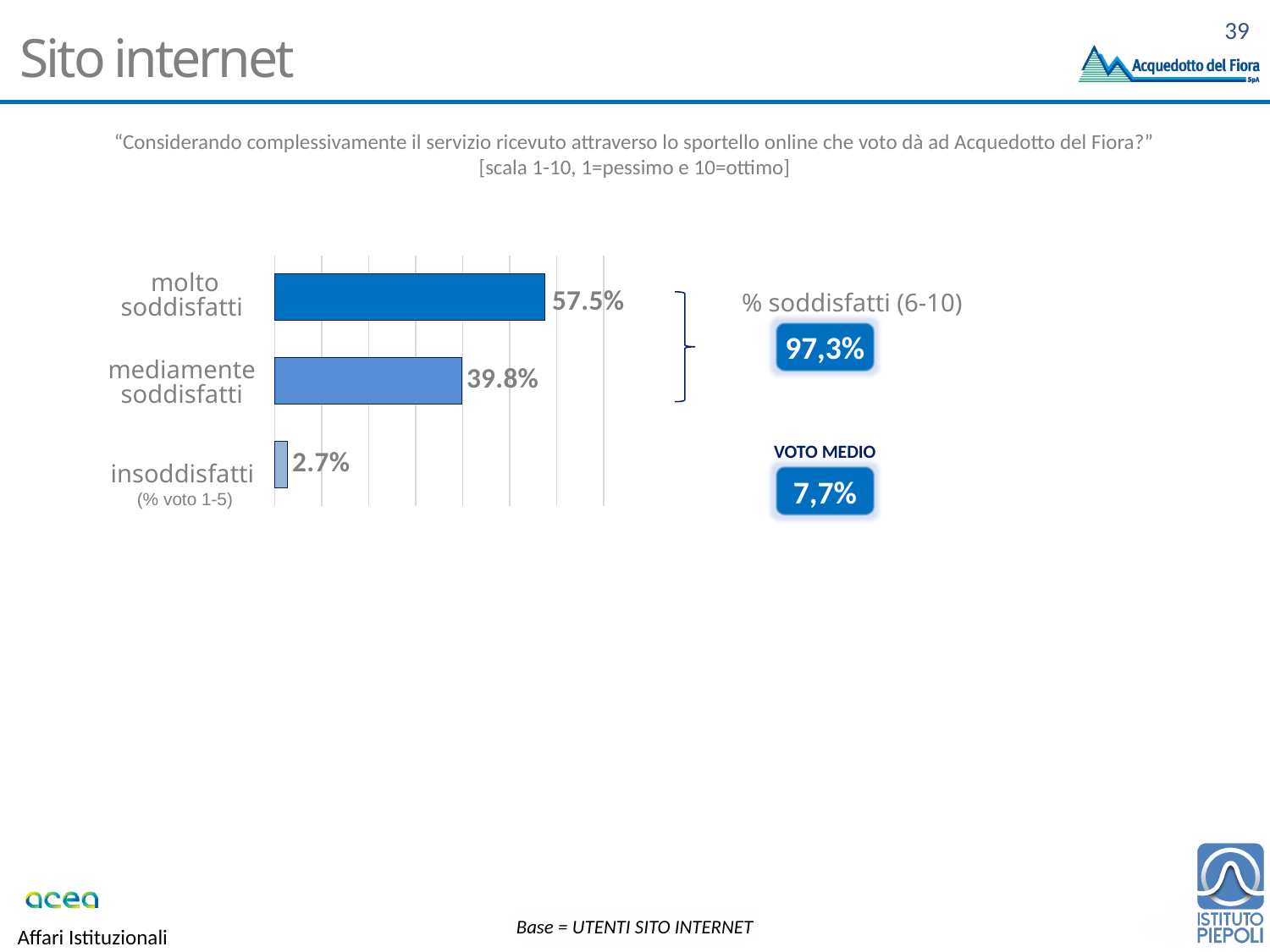
What is the value for "insoddisfatti"? 2.7% Which is larger, the value for "mediamente soddisfatti" or the value for "insoddisfatti"? mediamente soddisfatti What is the value for "molto soddisfatti"? 57.5% Which category has the lowest value? insoddisfatti How many categories are shown in the chart? 3 What is the value for "mediamente soddisfatti"? 39.8% What is the "VOTO MEDIO" shown on the slide? 7,7% What is the combined value of "molto soddisfatti" and "mediamente soddisfatti" (% soddisfatti 6-10) shown on the slide? 97,3% Which category has the highest value? molto soddisfatti What is the difference between the values for "mediamente soddisfatti" and "insoddisfatti"? 37.1% What is the difference between the values for "molto soddisfatti" and "mediamente soddisfatti"? 17.7% What kind of chart is shown on the slide? bar chart